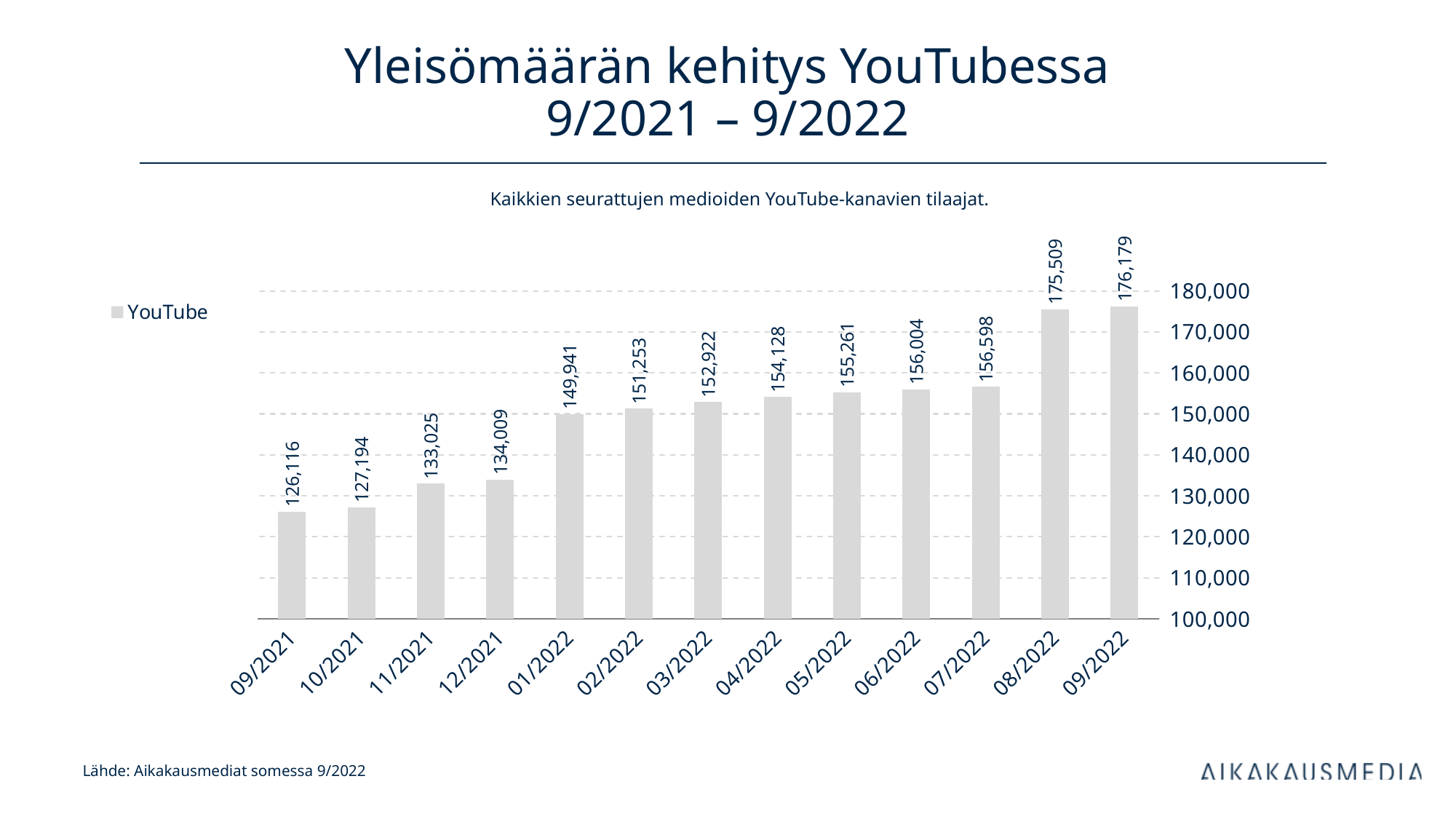
What is the value for 01/2022? 149,941 What is the difference between the values for 09/2022 and 09/2021? 50,063 Is the value for 11/2021 greater or less than 140,000? less Do the values rise or fall from 09/2021 to 09/2022? rise What is the value for 09/2021? 126,116 What kind of chart is shown on the slide? bar chart Which month has the lowest value? 09/2021 Which month has the highest value? 09/2022 What is the value for 08/2022? 175,509 Which is larger, the value for 12/2021 or the value for 01/2022? 01/2022 What is the difference between the values for 08/2022 and 07/2022? 18,911 How many months are shown on the x axis? 13